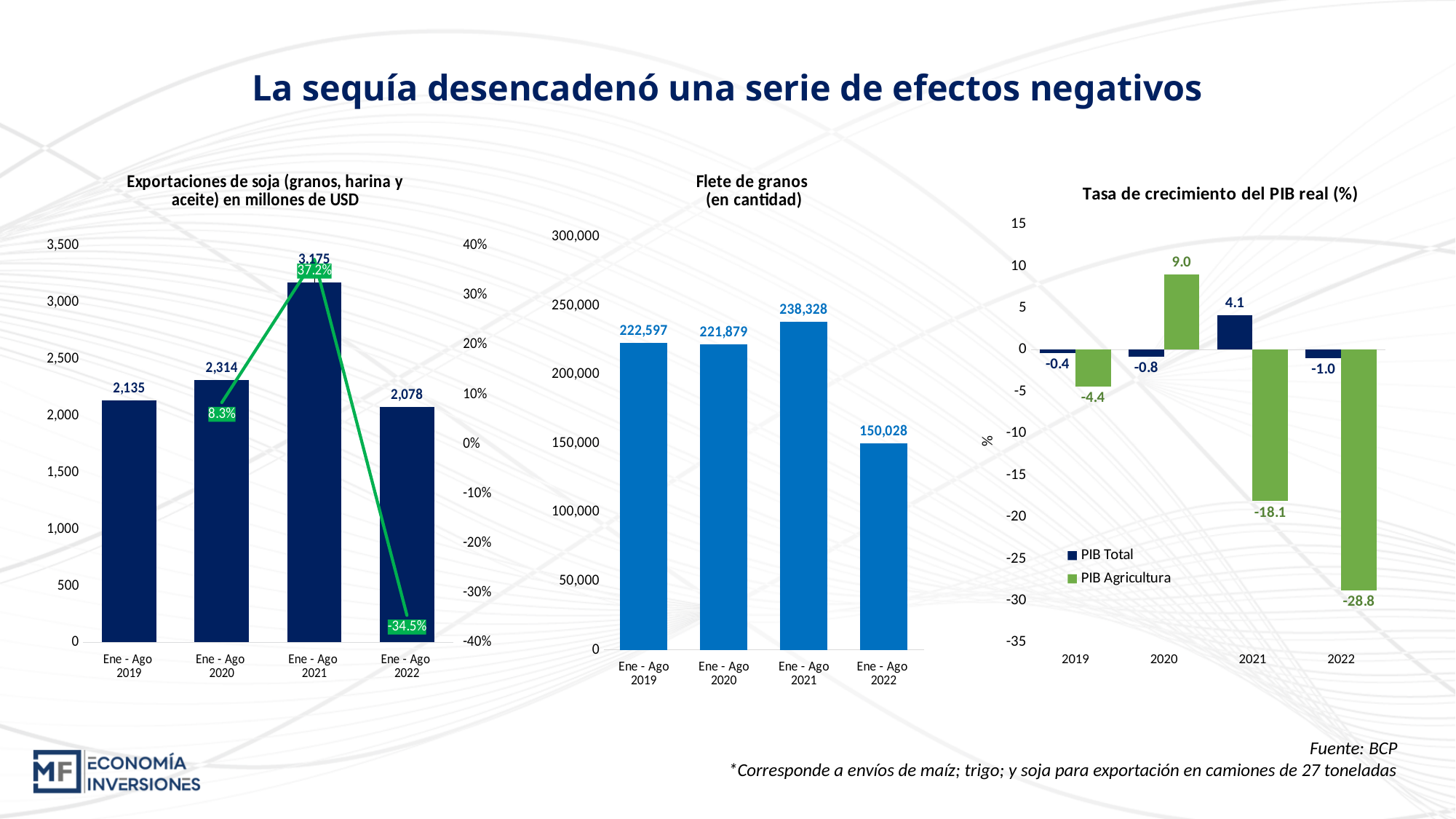
In the 'Tasa de crecimiento del PIB real' chart, what is the PIB Agricultura value for 2022? -28.8 In the 'Flete de granos' chart, what is the value for Ene - Ago 2020? 221,879 In the 'Exportaciones de soja' chart, what percentage change is labelled on the line for Ene - Ago 2022? -34.5% How many series does the legend of the 'Tasa de crecimiento del PIB real' chart list? 2 In the 'Tasa de crecimiento del PIB real' chart, which year has the highest PIB Total value? 2021 In the 'Flete de granos' chart, which period has the highest value? Ene - Ago 2021 In the 'Exportaciones de soja' chart, what is the difference between the values for Ene - Ago 2021 and Ene - Ago 2022? 1,097 In the 'Tasa de crecimiento del PIB real' chart, which is larger in 2020: PIB Total or PIB Agricultura? PIB Agricultura How many bars are in the 'Flete de granos' chart? 4 In the 'Exportaciones de soja' chart, what is the value for Ene - Ago 2021? 3,175 In the 'Flete de granos' chart, what is the difference between Ene - Ago 2021 and Ene - Ago 2022? 88,300 In the 'Exportaciones de soja' chart, which period has the lowest bar? Ene - Ago 2022